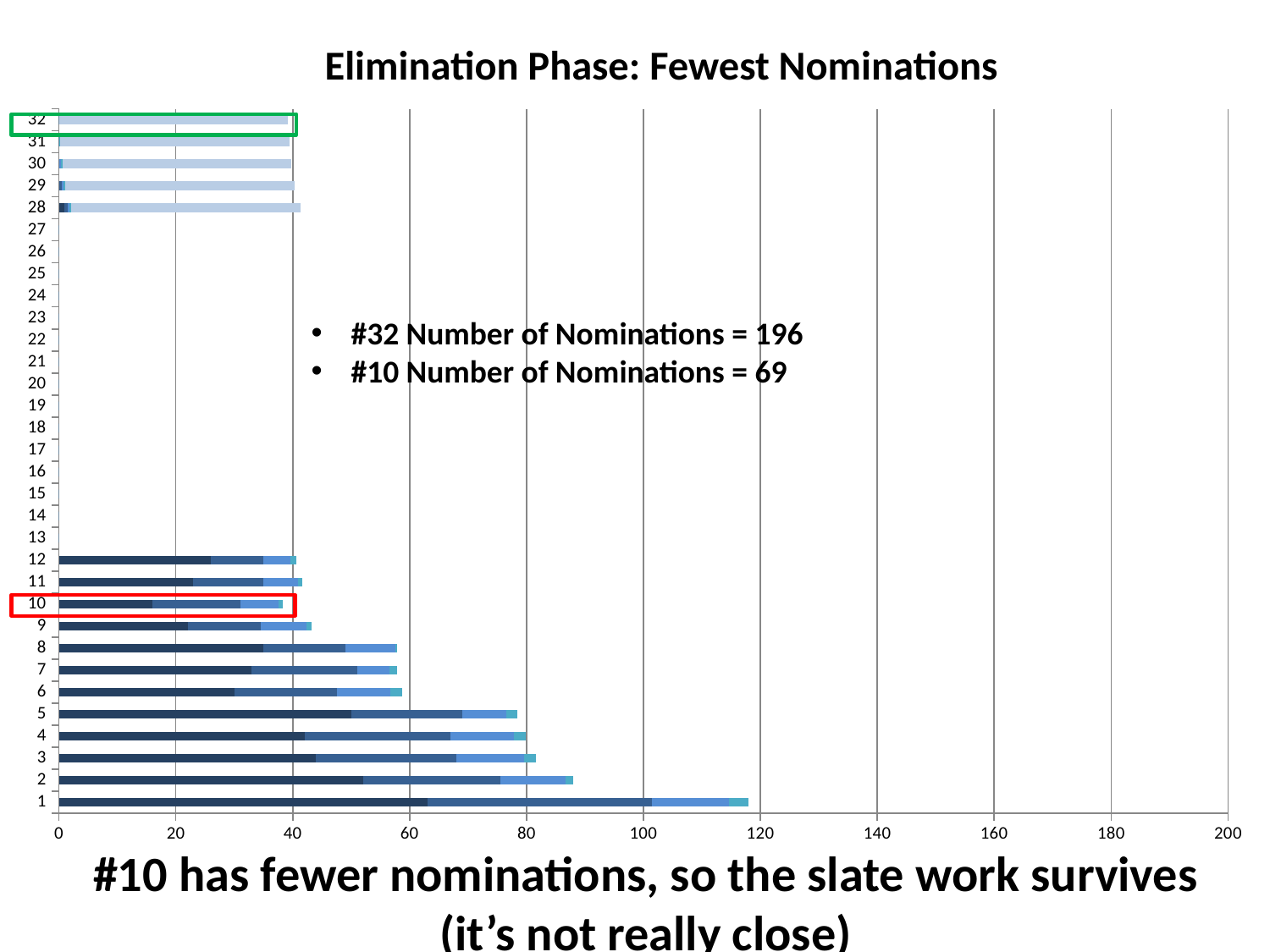
How many categories are listed on the vertical axis of the chart? 32 Is the total bar length for category 12 greater or less than 60? less According to the text on the slide, what is the number of nominations for #10? 69 Which has the longer bar, category 1 or category 2? 1 Which category has the longest bar in the chart? 1 What is the title of the chart? Elimination Phase: Fewest Nominations What kind of chart is shown on the slide? bar chart Is the total bar length for category 1 greater or less than 100? greater According to the text on the slide, what is the number of nominations for #32? 196 Which category is outlined with a red box on the chart? 10 Is the total bar length for category 2 greater or less than 100? less Which has the longer bar, category 5 or category 8? 5